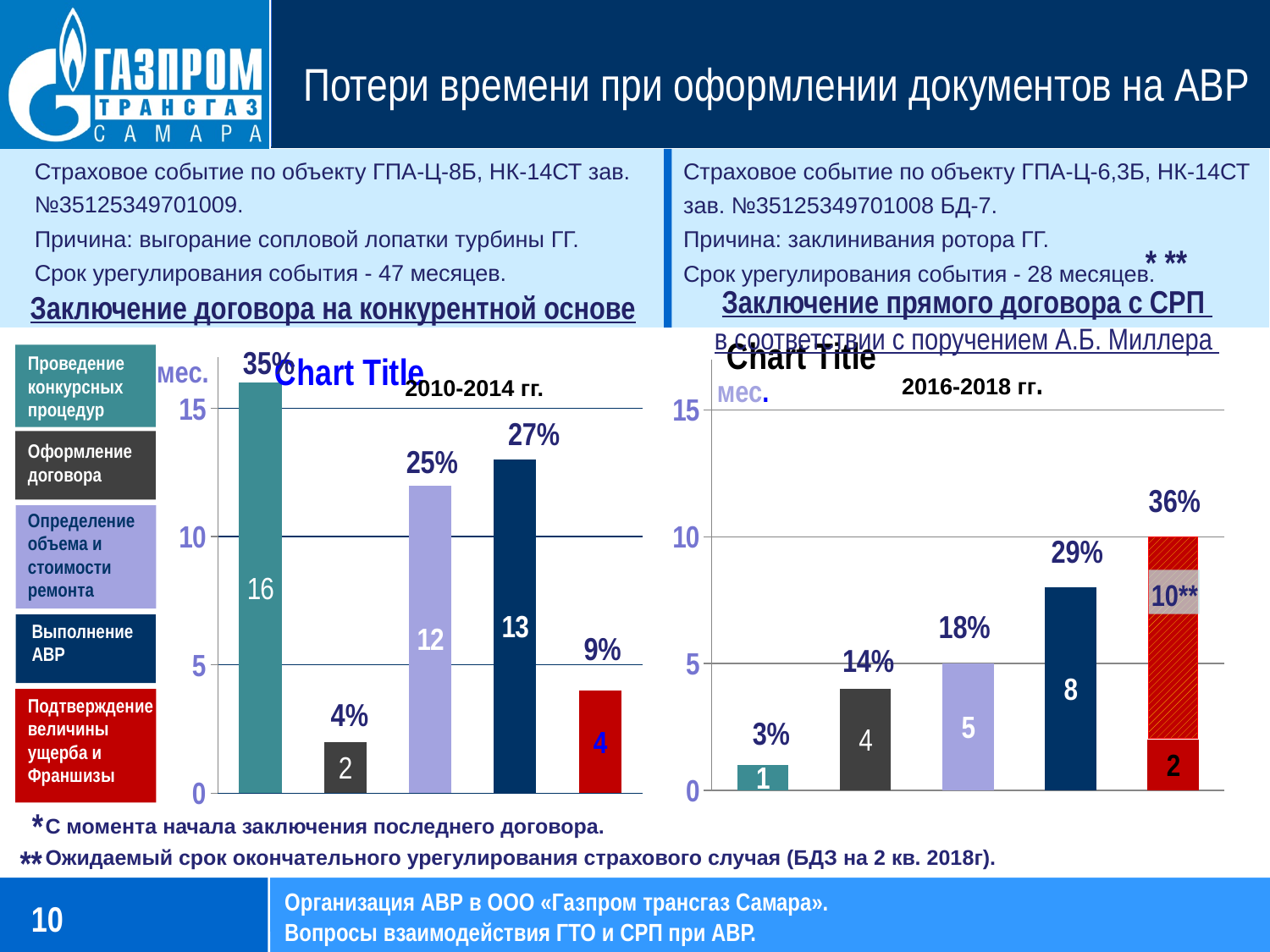
On the right chart (2016-2018 гг.), what value is shown for the navy bar (Выполнение АВР)? 8 What type of chart is used on the right side of the slide (2016-2018 гг.)? Bar chart On the left chart (2010-2014 гг.), what is the difference between the navy bar (13) and the light purple bar (12)? 1 On the left chart (2010-2014 гг.), what value is shown for the teal bar (Проведение конкурсных процедур)? 16 How many bars are plotted on the left chart (2010-2014 гг.)? 5 On the left chart (2010-2014 гг.), which is larger: the teal bar or the navy bar? The teal bar (16) On the right chart (2016-2018 гг.), which bar has the lowest value? Проведение конкурсных процедур (1) On the right chart (2016-2018 гг.), what percentage label is shown above the light purple bar (Определение объема и стоимости ремонта)? 18% On the left chart (2010-2014 гг.), what percentage label is shown above the dark grey bar (Оформление договора)? 4% On the left chart (2010-2014 гг.), which bar is the tallest? Проведение конкурсных процедур (16) What unit label is shown at the top of the vertical axis on both charts? мес.